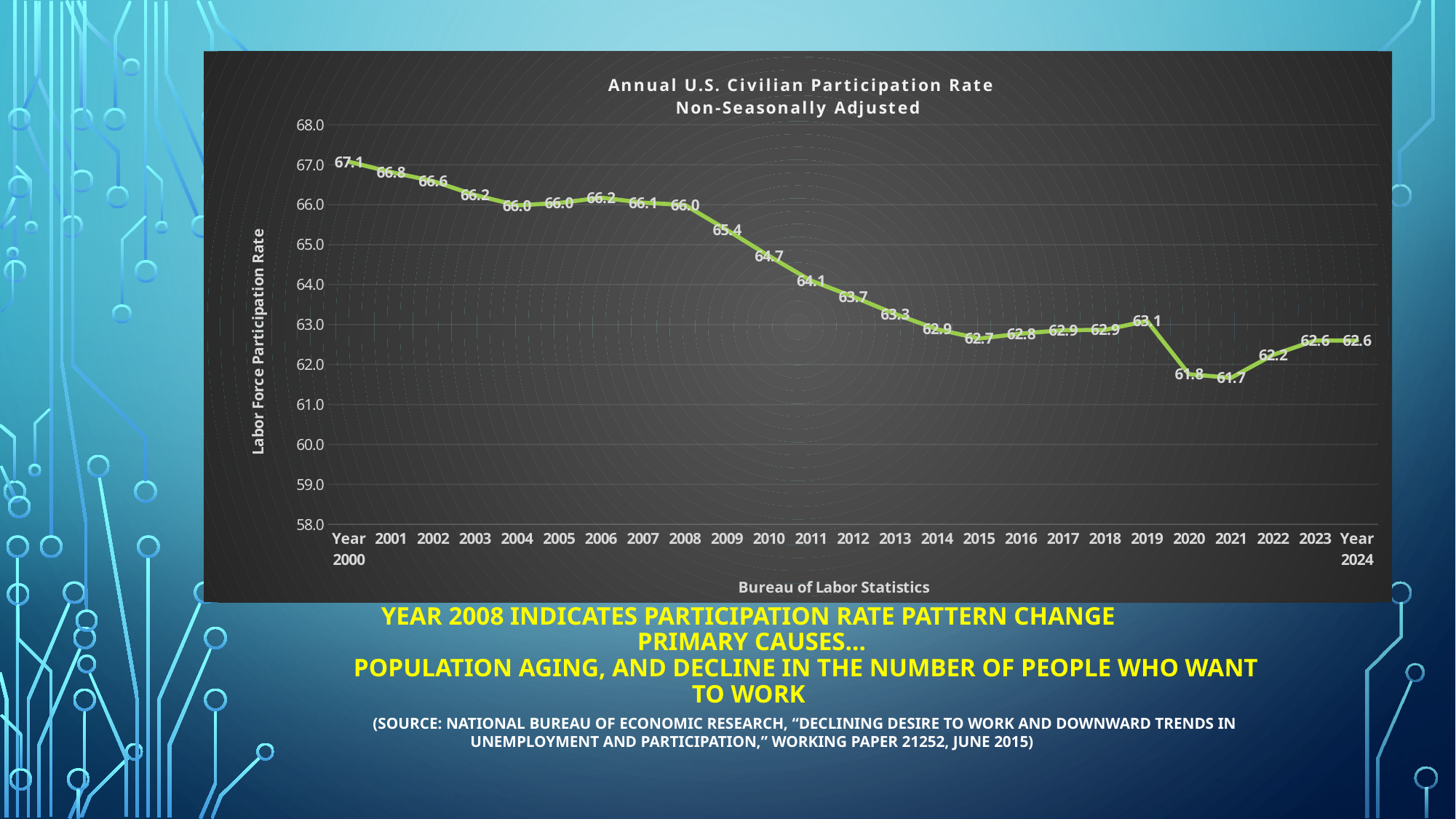
What is the labor force participation rate for 2020? 61.8 What is the title of the chart? Annual U.S. Civilian Participation Rate Non-Seasonally Adjusted What is the difference between the participation rate in 2000 and in 2024? 4.5 Which year has the highest participation rate? 2000 What is the labor force participation rate for 2000? 67.1 What is the labor force participation rate for 2024? 62.6 Which year has the lowest participation rate? 2021 What kind of chart is shown on the slide? Line chart Which year has a higher participation rate, 2010 or 2015? 2010 How many years are plotted on the chart? 25 What is the difference between the participation rate in 2019 and in 2020? 1.3 What is the labor force participation rate for 2008? 66.0